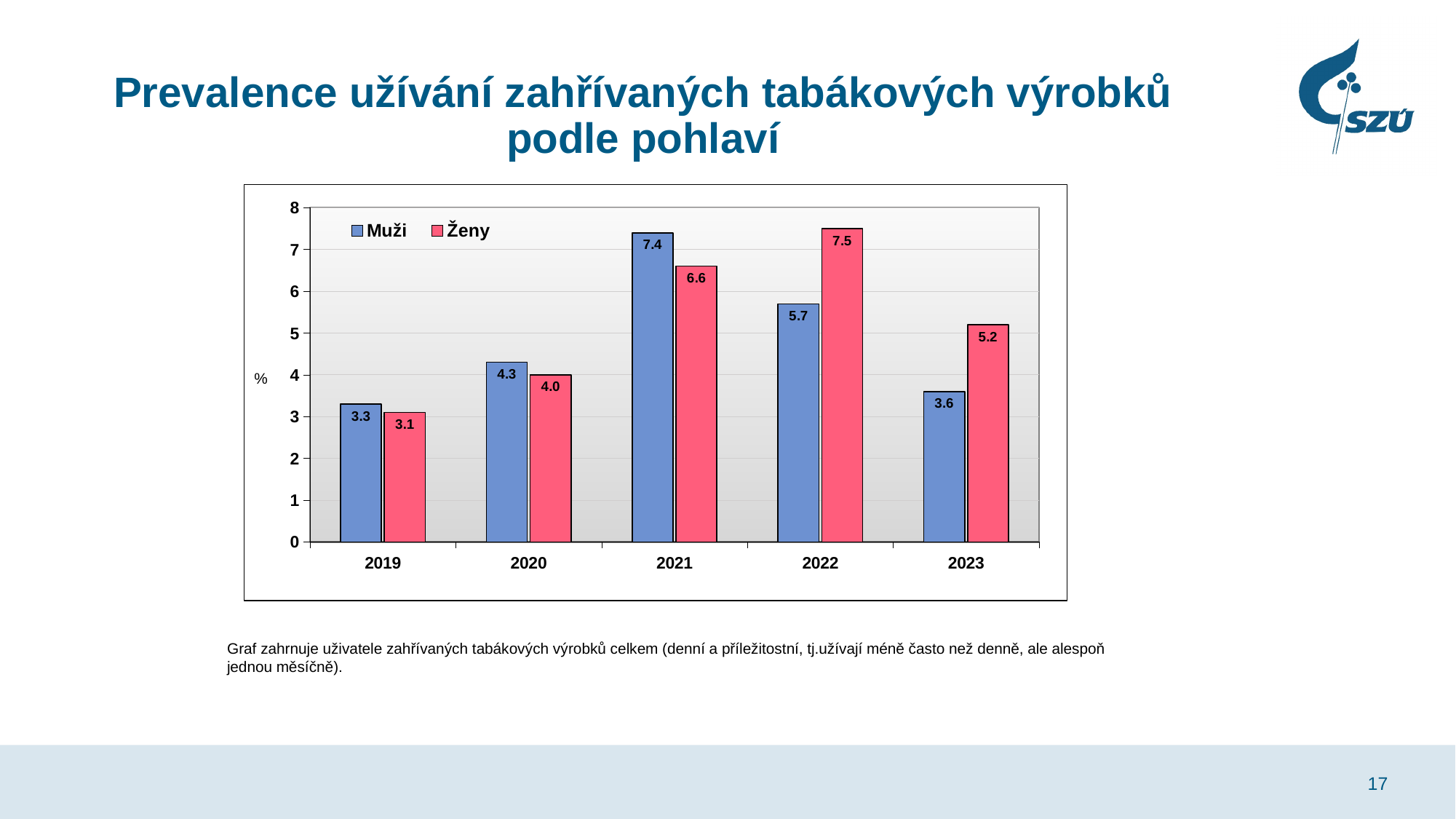
In which year is the value for Muži lowest? 2019 What are the two series named in the legend? Muži and Ženy Is the value for Ženy in 2021 greater or less than 6? greater What is the value for Muži in 2021? 7.4 What kind of chart is shown on the slide? bar chart What is the difference between the Muži and Ženy values in 2022? 1.8 Which is larger in 2020, the value for Muži or for Ženy? Muži How many years are shown on the x axis? 5 What is the value for Ženy in 2019? 3.1 What is the value for Ženy in 2023? 5.2 How many series does the legend list? 2 In which year is the value for Ženy highest? 2022